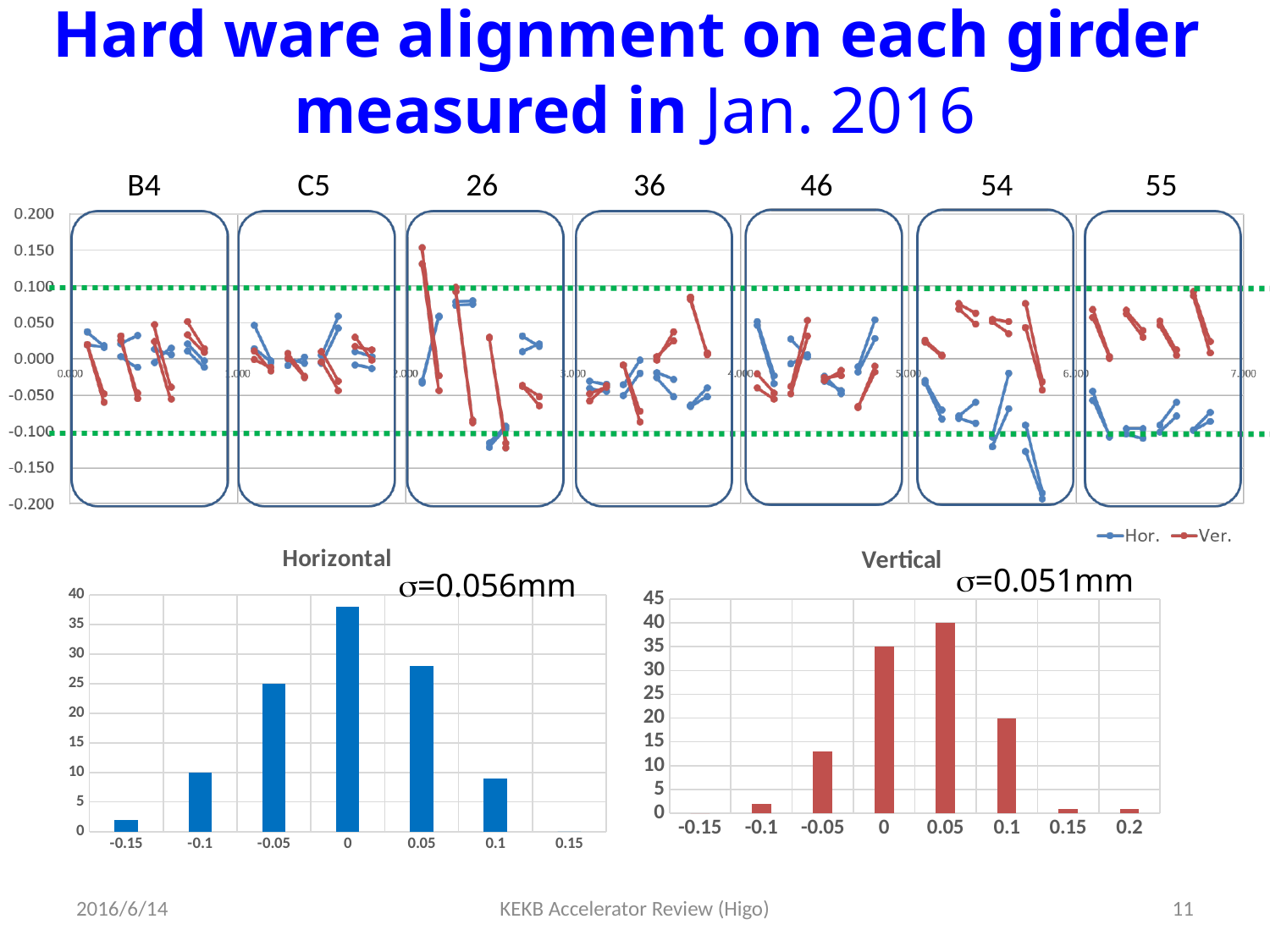
How many series does the legend of the top chart list? 2 What kind of chart is the Horizontal chart at the bottom left? bar chart In the Horizontal chart, is the value for the 0 bin greater or less than 35? greater In the Vertical chart, which is larger, the bar for 0 or the bar for 0.05? 0.05 In the Vertical chart, what is the value for the 0.05 bin? 40 In the Horizontal chart, what is the value for the -0.05 bin? 25 In the Horizontal chart, what is the value for the -0.1 bin? 10 In the Vertical chart, what is the value for the 0.1 bin? 20 In the Vertical chart, which bin has the highest bar? 0.05 In the Horizontal chart, which bin has the highest bar? 0 In the Vertical chart, what is the difference between the 0.05 bin and the 0.1 bin? 20